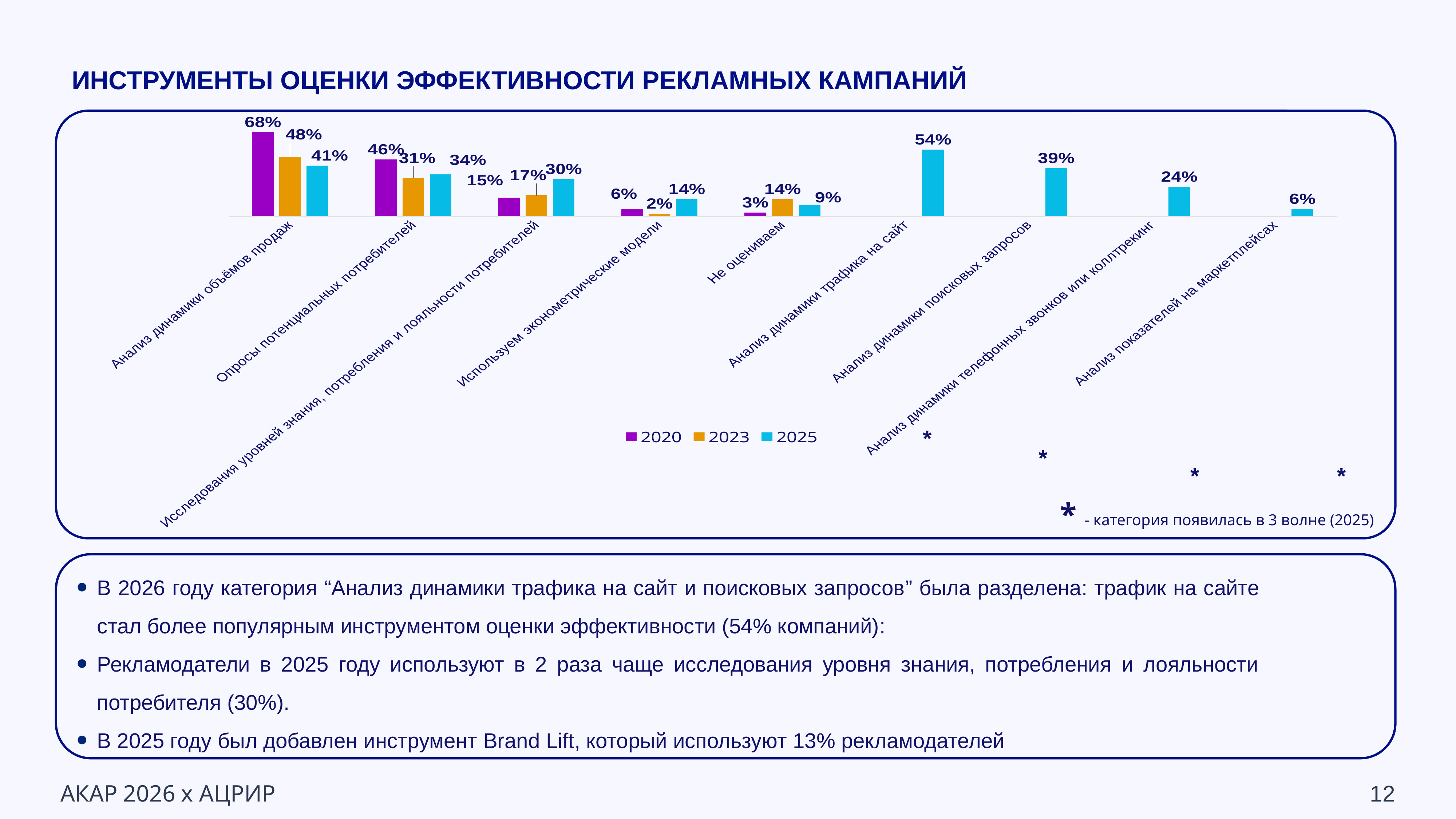
Which category has the lowest 2023 value? Используем эконометрические модели Do the values for "Исследования уровней знания, потребления и лояльности потребителей" rise or fall from 2020 to 2025? Rise What is the difference between the 2020 and 2025 values for "Анализ динамики объёмов продаж"? 27% How many categories are shown on the x axis? 9 How many series does the legend list? 3 Which is larger for "Опросы потенциальных потребителей": the 2023 value or the 2025 value? 2025 Which category has the highest 2025 value? Анализ динамики трафика на сайт What kind of chart is shown on the slide? Bar chart What is the 2020 value for "Анализ динамики объёмов продаж"? 68% What is the 2025 value for "Анализ динамики телефонных звонков или коллтрекинг"? 24% What is the 2023 value for "Не оцениваем"? 14% What is the 2025 value for "Анализ динамики трафика на сайт"? 54%